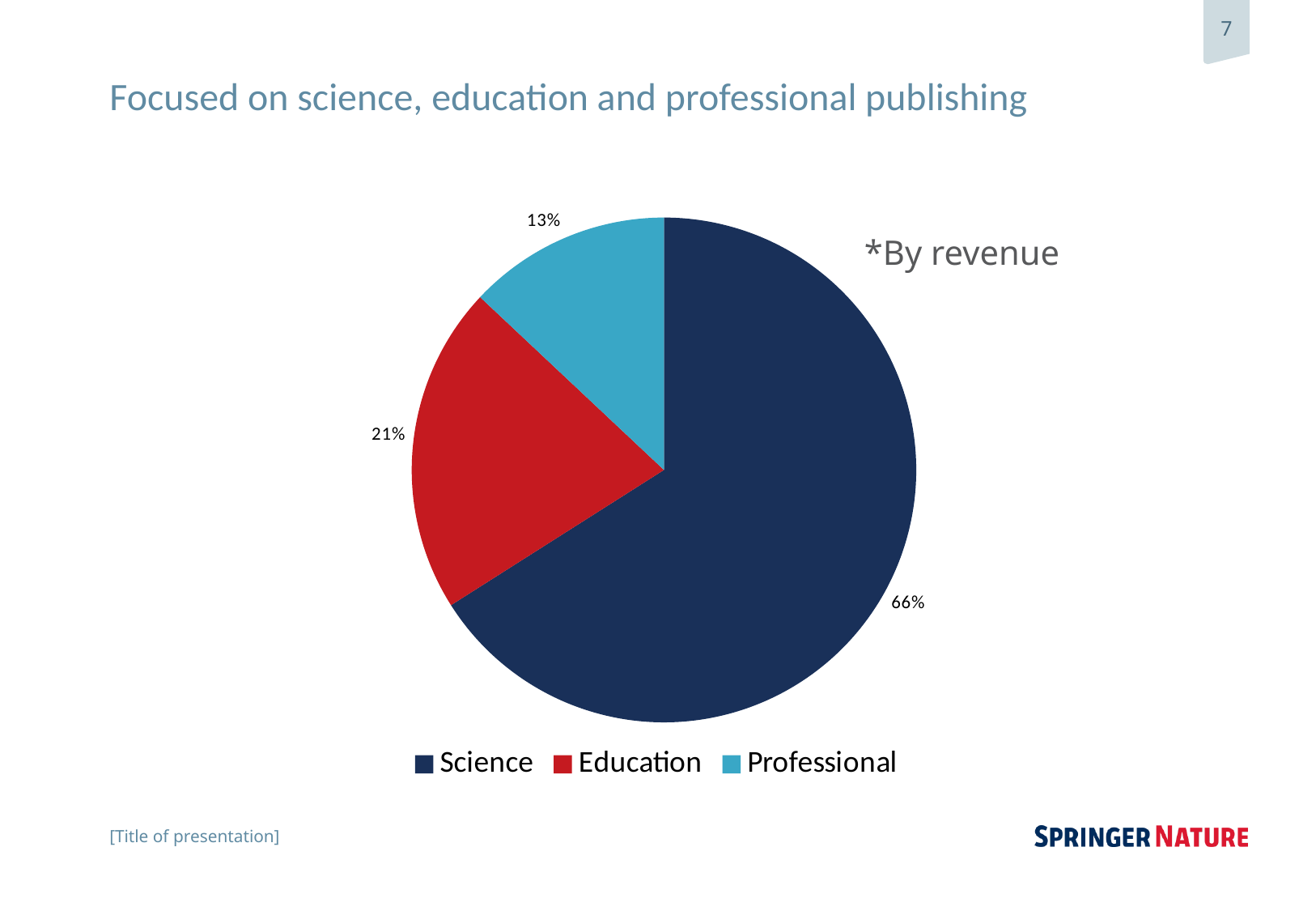
What share of revenue does Science account for? 66% Which segment has the smallest share of the pie? Professional What share of revenue does Professional account for? 13% Which is larger, the Education share or the Professional share? Education What is the difference in percentage points between the Science and Education shares? 45 According to the note next to the chart, what are the shares measured by? By revenue What share of revenue does Education account for? 21% What kind of chart is shown on the slide? pie chart How many segments does the pie chart have? 3 Which segment has the largest share of the pie? Science What is the difference in percentage points between the Education and Professional shares? 8 What colour is the Science segment in the pie chart? dark blue